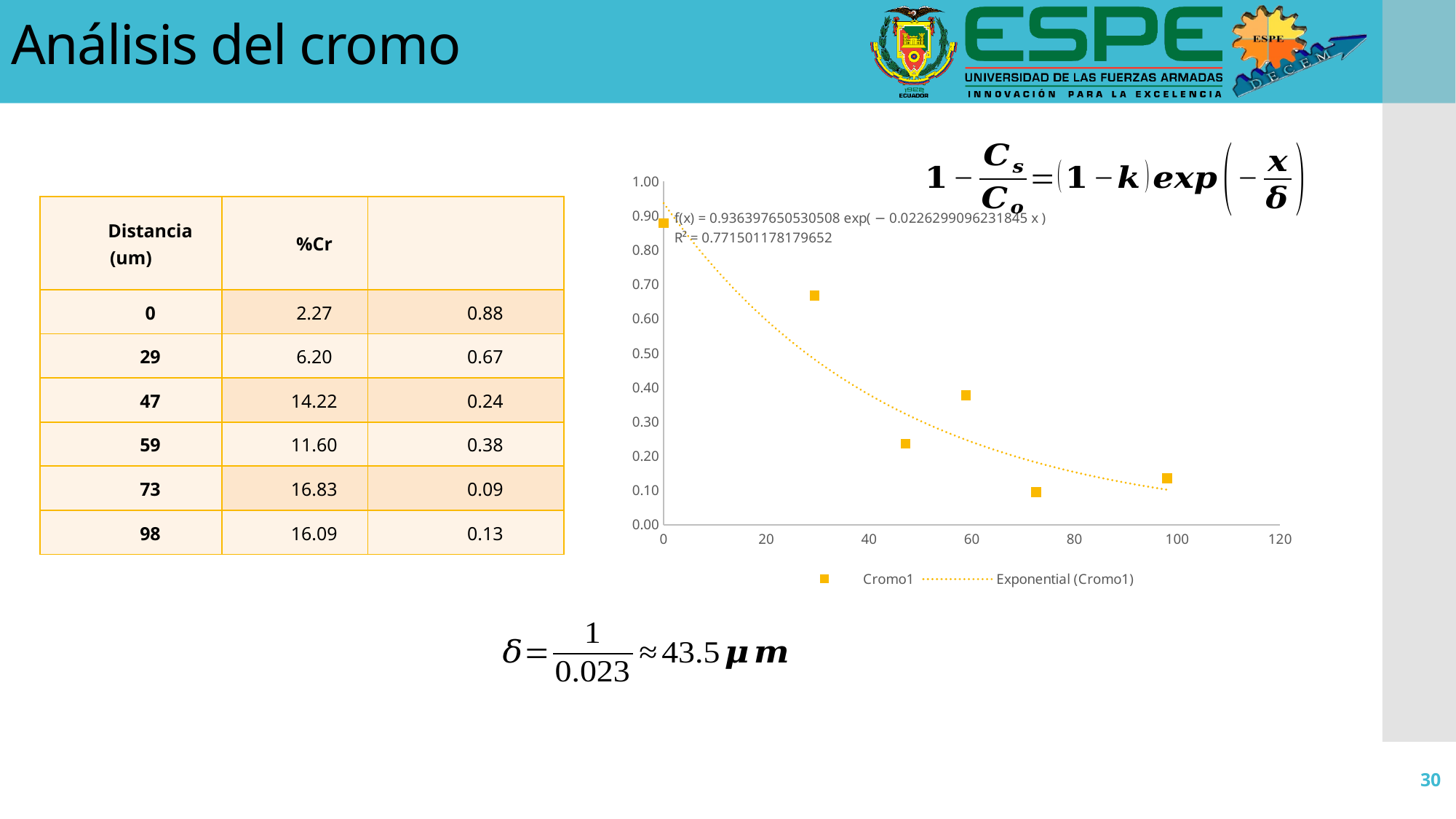
What is the name of the trendline series in the chart legend? Exponential (Cromo1) Is the value of the point at x = 0 greater or less than 0.80? greater Which plotted point has the lowest value? the point at x = 73 Do the plotted values generally rise or fall as the x value increases? fall What R² value is printed on the chart for the trendline? 0.771501178179652 Is the value of the point near x = 47 greater or less than 0.30? less Is the value of the point near x = 30 greater or less than 0.60? greater How many data points are plotted in the chart? 6 How many entries does the chart legend list? 2 What kind of chart is shown on the slide? scatter chart Which plotted point has the highest value? the point at x = 0